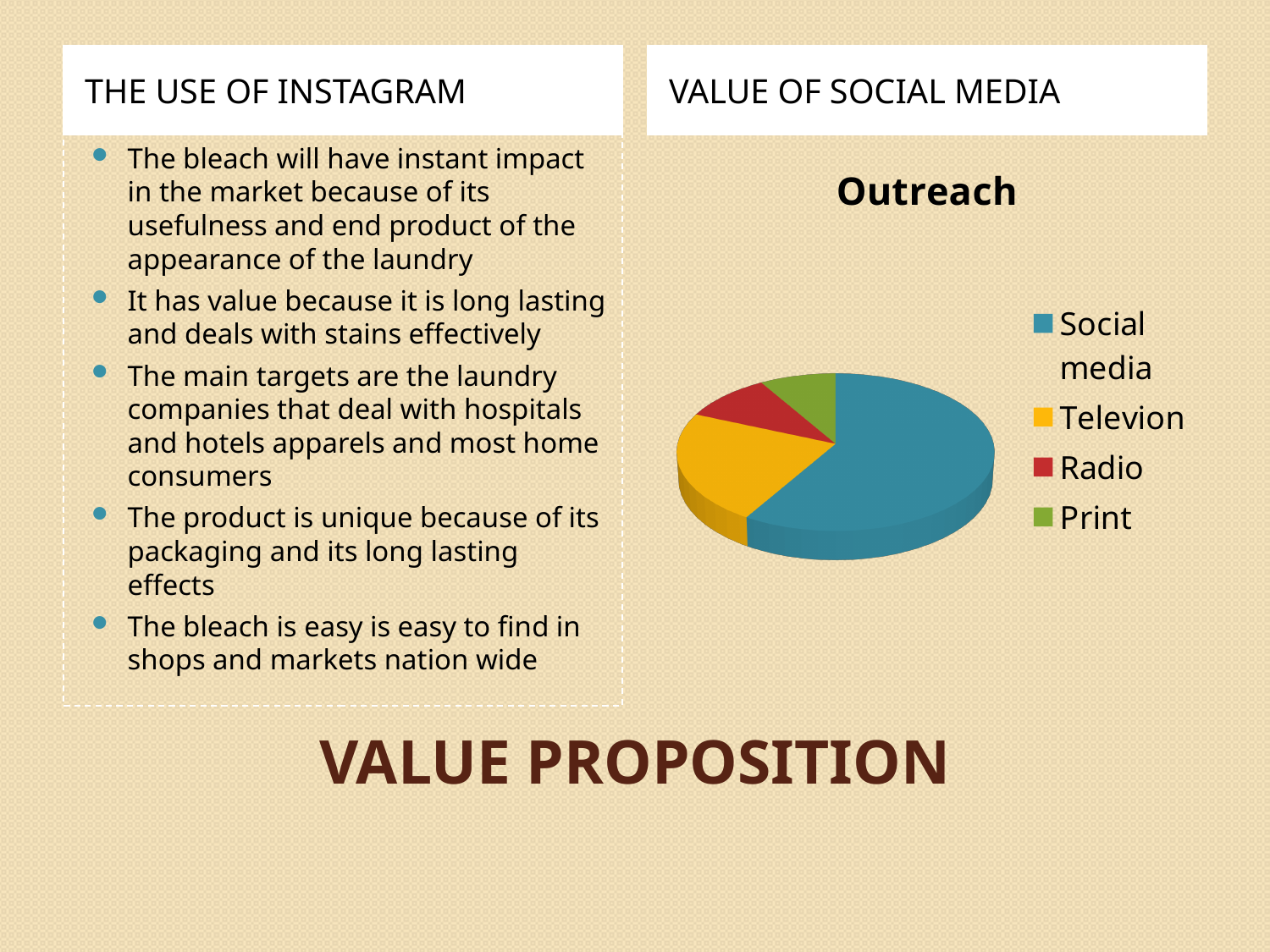
How many slices does the Outreach pie chart have? 4 In the Outreach pie chart, which slice is larger: Social media or Radio? Social media What colour represents Social media in the Outreach pie chart? Blue In the Outreach pie chart, which slice is larger: Televion or Radio? Televion What is the title of the pie chart? Outreach How many entries does the legend of the Outreach chart list? 4 What kind of chart is shown on the slide? Pie chart Which category has the largest slice in the Outreach pie chart? Social media In the Outreach pie chart, which slice is larger: Televion or Print? Televion